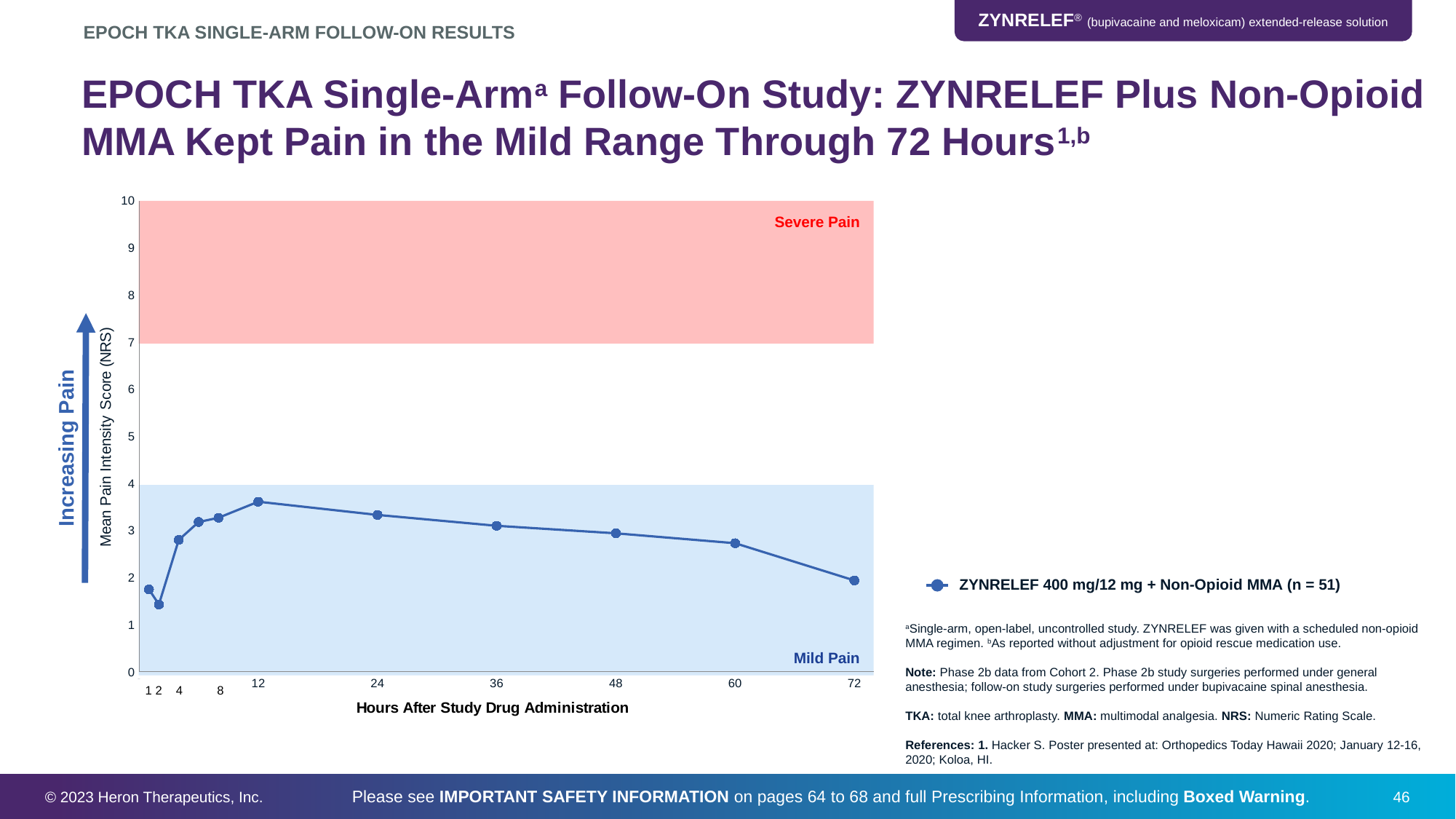
At which hour after study drug administration is the mean pain intensity score lowest? 2 Is the mean pain intensity score at 2 hours greater or less than 2? less How many series does the legend list? 1 Is the mean pain intensity score at 60 hours greater or less than 3? less Which has the higher mean pain intensity score, 12 hours or 72 hours? 12 hours Is the mean pain intensity score at 24 hours greater or less than 3? greater At which hour after study drug administration is the mean pain intensity score highest? 12 What is the legend entry for the plotted series? ZYNRELEF 400 mg/12 mg + Non-Opioid MMA (n = 51) What kind of chart is shown on the slide? line chart From 12 hours to 72 hours, does the mean pain intensity score rise or fall? fall What is the title of the x axis? Hours After Study Drug Administration